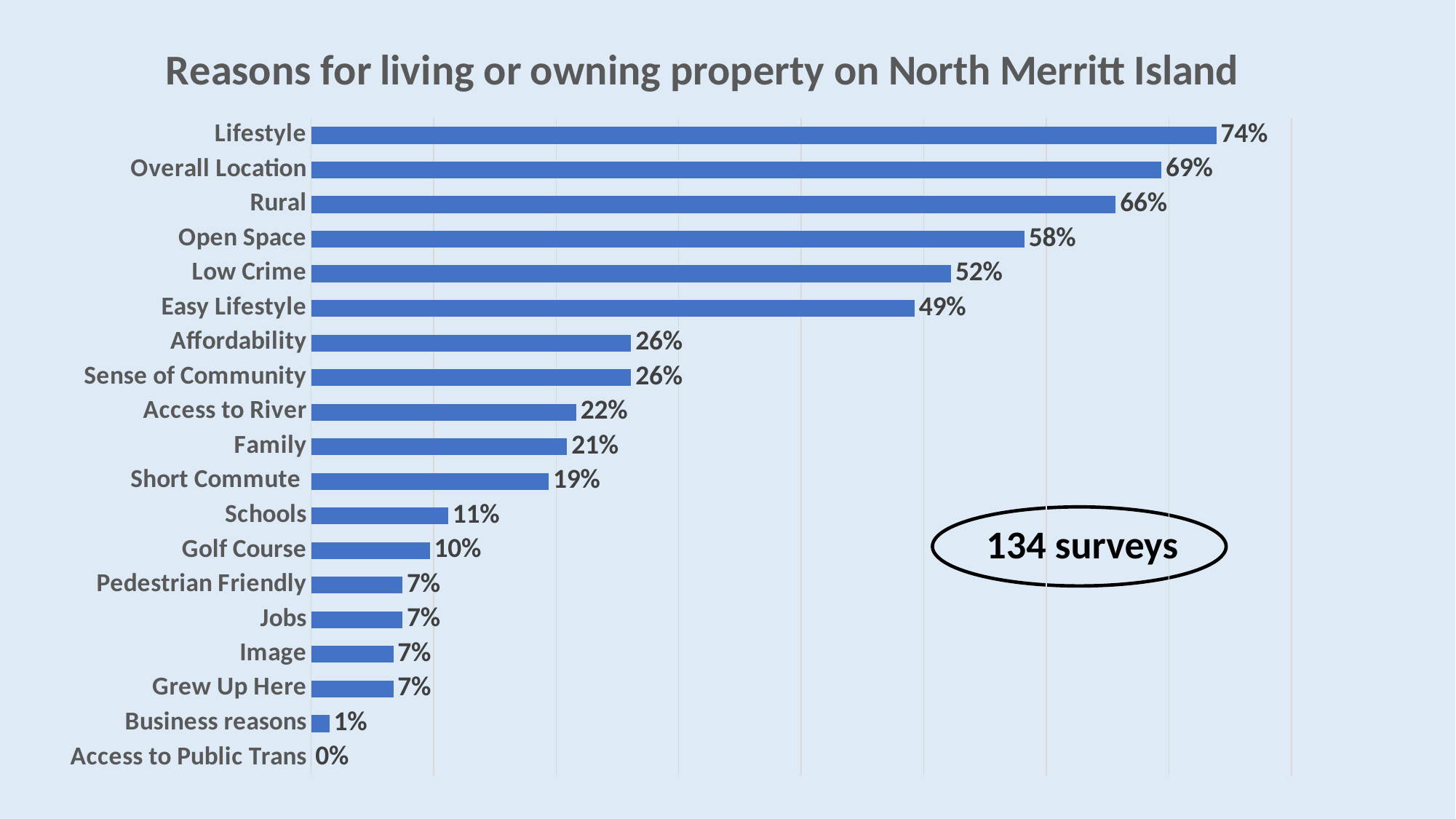
What is the difference in percentage points between Easy Lifestyle and Affordability? 23 Which reason has the highest percentage on the chart? Lifestyle What percentage is shown for Short Commute? 19% What type of chart is shown on the slide? Bar chart Which has a higher percentage, Rural or Open Space? Rural Which has a higher percentage, Schools or Golf Course? Schools How many surveys does the slide say the chart is based on? 134 surveys What is the value shown for Low Crime? 52% What percentage of respondents cited Lifestyle as a reason for living or owning property on North Merritt Island? 74% Which reason has the lowest percentage on the chart? Access to Public Trans What is the difference in percentage points between Lifestyle and Overall Location? 5 How many reasons (categories) are listed on the chart? 19